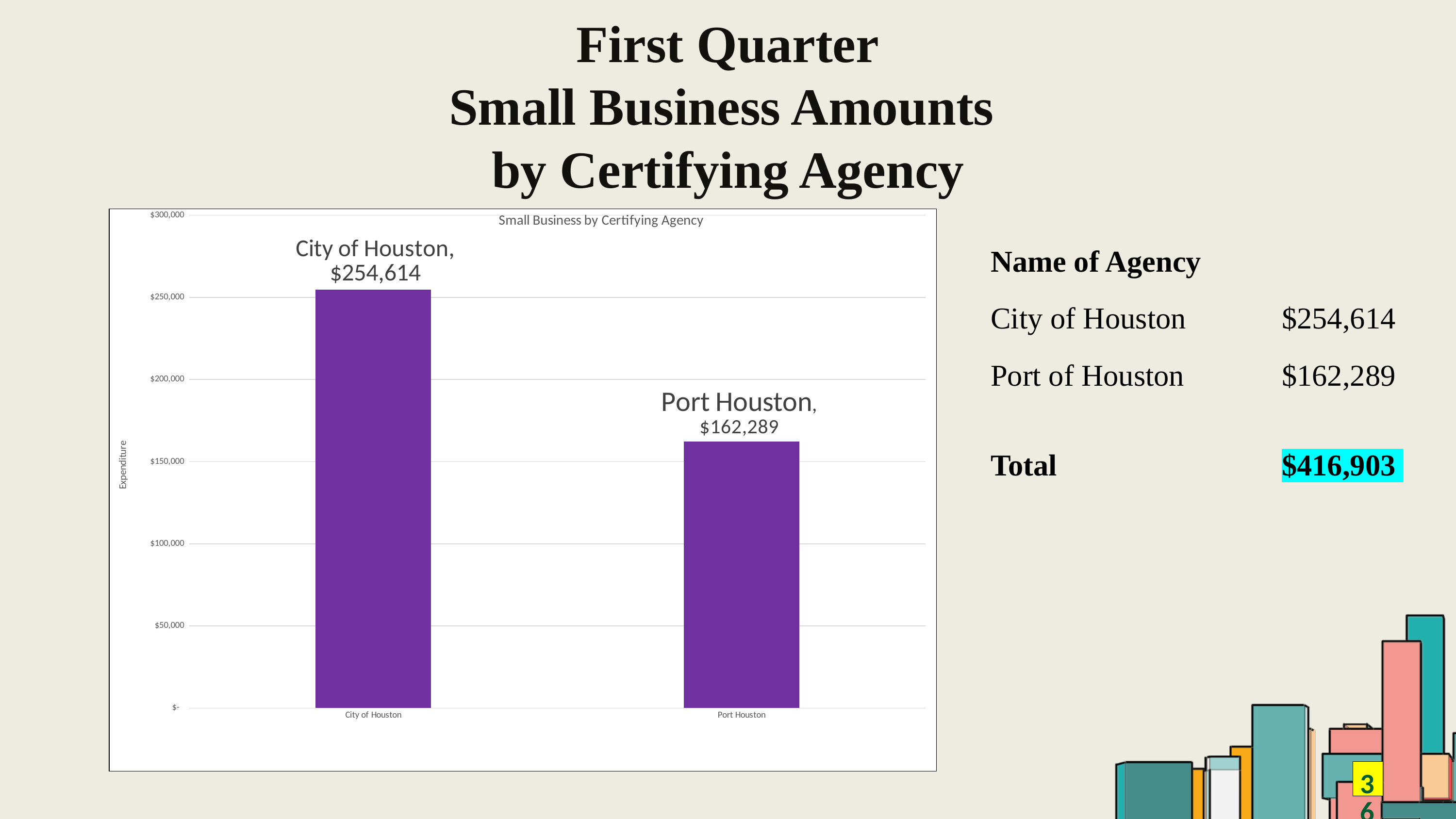
How many categories are shown in the chart? 2 What is the label on the vertical axis of the chart? Expenditure Which category has the lowest value? Port Houston What is the value for City of Houston? $254,614 What is the title of the chart? Small Business by Certifying Agency Which category has the highest value? City of Houston What is the difference between the City of Houston and Port Houston values? $92,325 What kind of chart is shown? bar chart Which is larger, the value for City of Houston or the value for Port Houston? City of Houston Is the value for City of Houston greater or less than $250,000? greater What is the value for Port Houston? $162,289 Is the value for Port Houston greater or less than $200,000? less